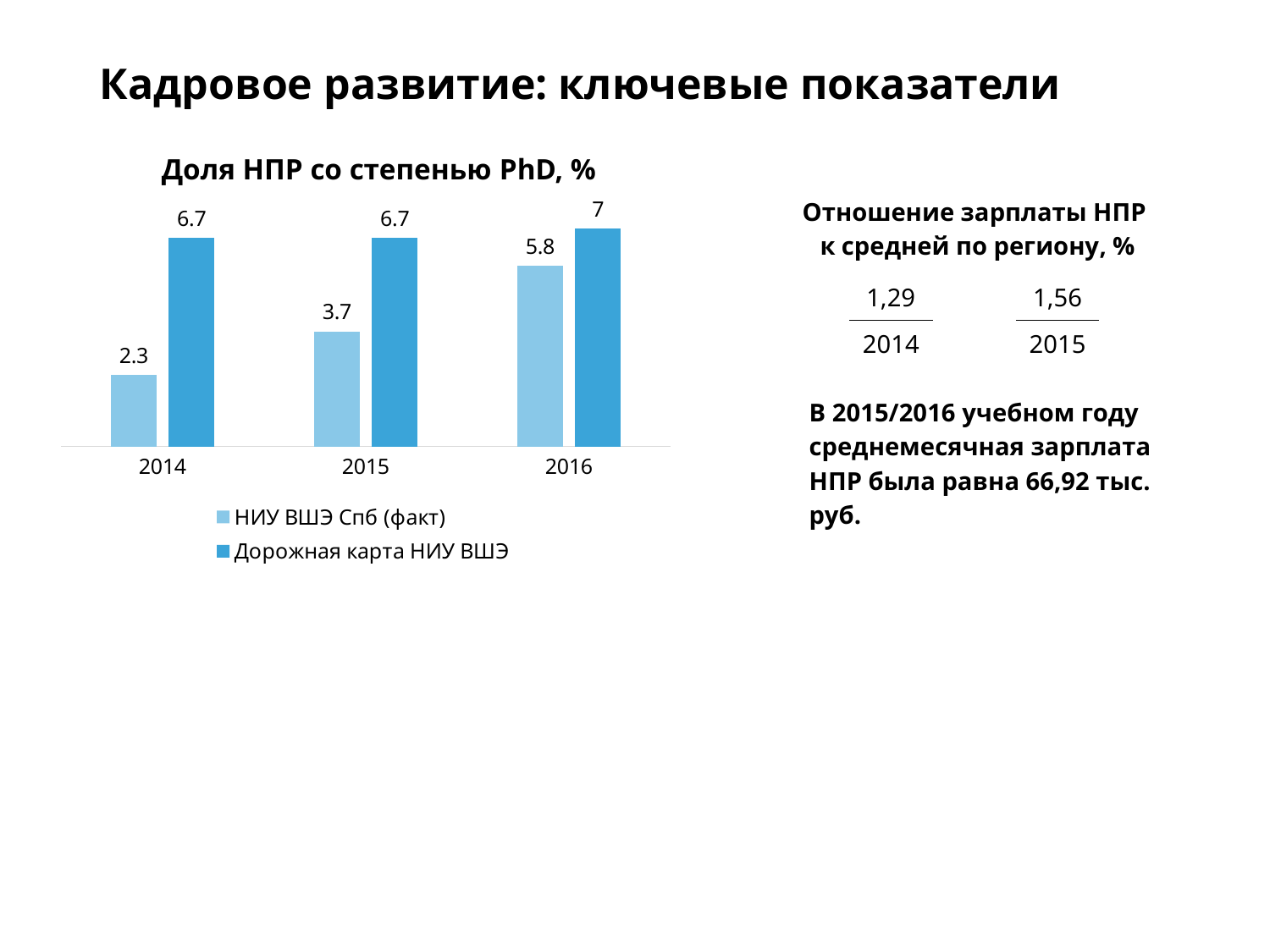
What is the difference between Дорожная карта НИУ ВШЭ and НИУ ВШЭ Спб (факт) in 2016? 1.2 How many series does the chart legend list? 2 What is the value for НИУ ВШЭ Спб (факт) in 2015? 3.7 What kind of chart is shown on the slide? bar chart What is the value for Дорожная карта НИУ ВШЭ in 2016? 7 In which year is the НИУ ВШЭ Спб (факт) value highest? 2016 Which is larger in 2015: НИУ ВШЭ Спб (факт) or Дорожная карта НИУ ВШЭ? Дорожная карта НИУ ВШЭ What is the value for НИУ ВШЭ Спб (факт) in 2014? 2.3 What is the difference between Дорожная карта НИУ ВШЭ and НИУ ВШЭ Спб (факт) in 2014? 4.4 Does the НИУ ВШЭ Спб (факт) value rise or fall from 2014 to 2016? rise How many years are shown on the x axis of the chart? 3 In which year is the НИУ ВШЭ Спб (факт) value lowest? 2014